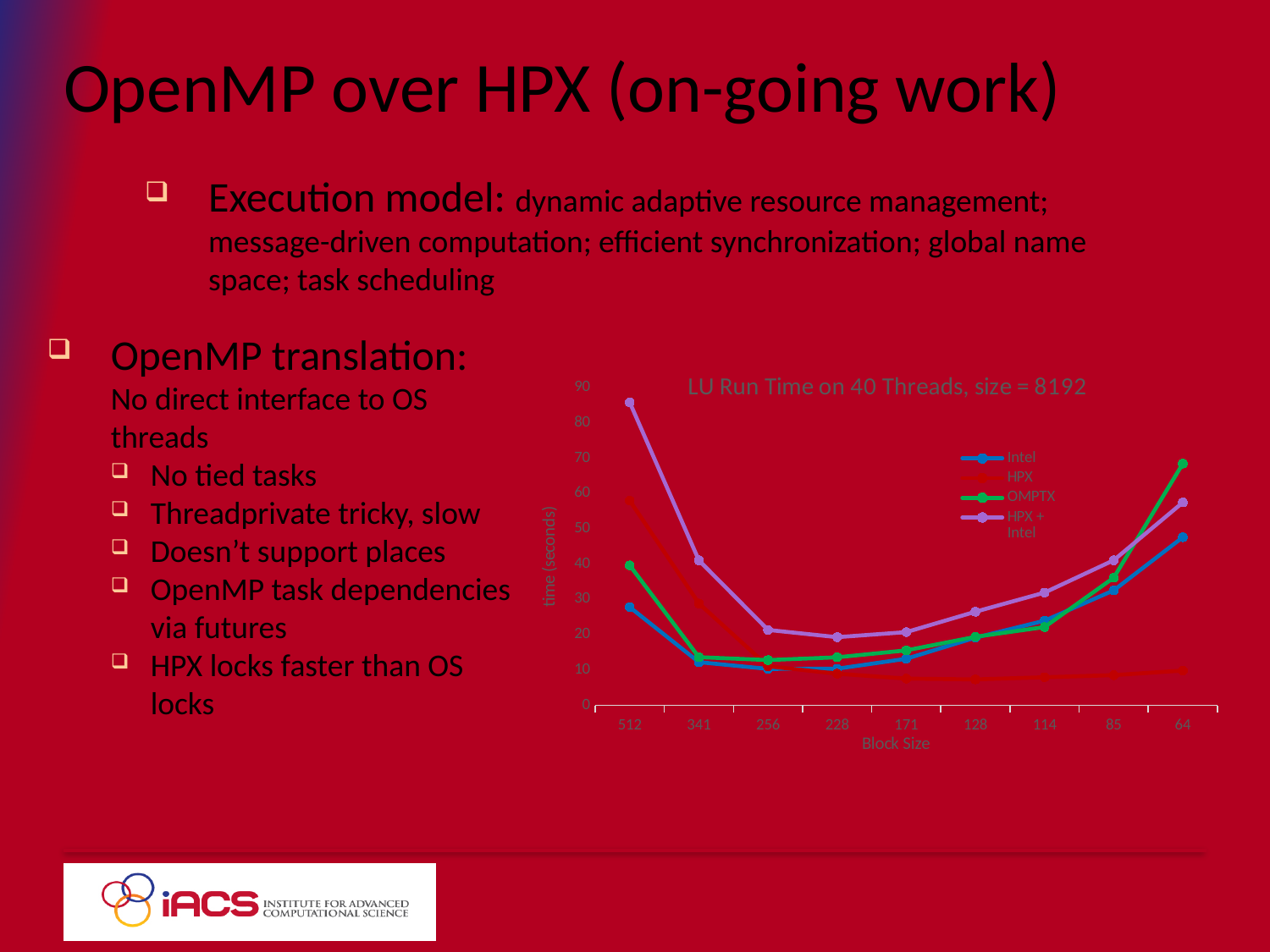
Is the value for OMPTX at block size 64 greater or less than 60? greater What kind of chart is shown on the slide? line chart Is the value for Intel at block size 512 greater or less than 30? less Is the value for HPX + Intel at block size 512 greater or less than 80? greater Which series has the lowest value at block size 64? HPX At block size 512, which is larger, the Intel value or the OMPTX value? OMPTX What is the title of the chart? LU Run Time on 40 Threads, size = 8192 What is the label of the y axis? time (seconds) Which series has the highest value at block size 512? HPX + Intel Which series has the highest value at block size 64? OMPTX How many block size categories are shown on the x axis? 9 How many series does the chart legend list? 4